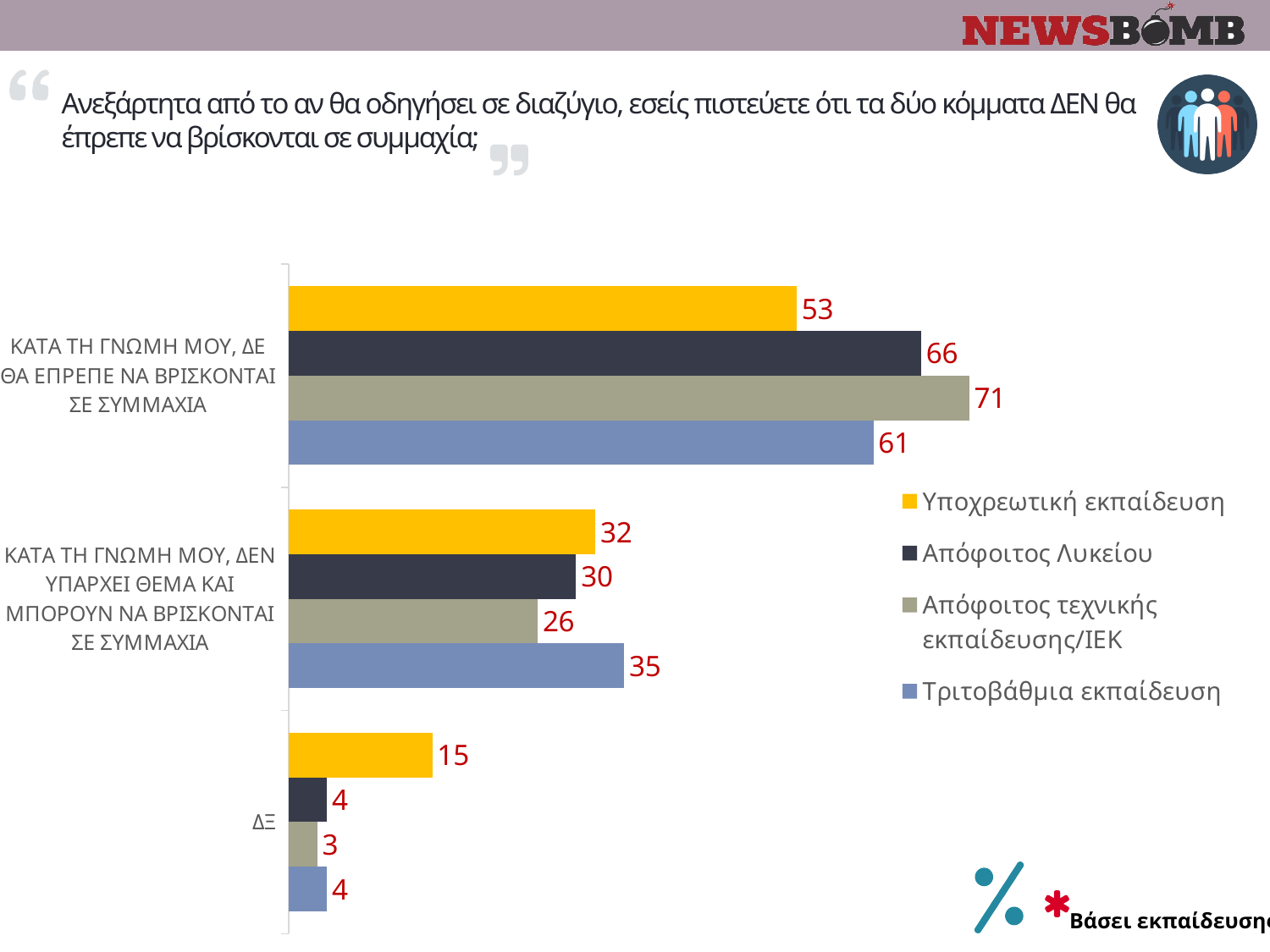
What is the value for Απόφοιτος τεχνικής εκπαίδευσης/ΙΕΚ in the category 'ΚΑΤΑ ΤΗ ΓΝΩΜΗ ΜΟΥ, ΔΕ ΘΑ ΕΠΡΕΠΕ ΝΑ ΒΡΙΣΚΟΝΤΑΙ ΣΕ ΣΥΜΜΑΧΙΑ'? 71 Which legend entry is shown in yellow? Υποχρεωτική εκπαίδευση What is the difference between the Υποχρεωτική εκπαίδευση value and the Απόφοιτος Λυκείου value in the category 'ΔΞ'? 11 Which education group has the lowest value in the category 'ΔΞ'? Απόφοιτος τεχνικής εκπαίδευσης/ΙΕΚ What kind of chart is shown on the slide? Bar chart What is the value for Υποχρεωτική εκπαίδευση in the category 'ΔΞ'? 15 Which education group has the highest value in the category 'ΚΑΤΑ ΤΗ ΓΝΩΜΗ ΜΟΥ, ΔΕ ΘΑ ΕΠΡΕΠΕ ΝΑ ΒΡΙΣΚΟΝΤΑΙ ΣΕ ΣΥΜΜΑΧΙΑ'? Απόφοιτος τεχνικής εκπαίδευσης/ΙΕΚ How many series does the legend list? 4 What is the value for Τριτοβάθμια εκπαίδευση in the category 'ΚΑΤΑ ΤΗ ΓΝΩΜΗ ΜΟΥ, ΔΕΝ ΥΠΑΡΧΕΙ ΘΕΜΑ ΚΑΙ ΜΠΟΡΟΥΝ ΝΑ ΒΡΙΣΚΟΝΤΑΙ ΣΕ ΣΥΜΜΑΧΙΑ'? 35 How many categories are shown on the vertical axis of the chart? 3 What is the difference between the Απόφοιτος τεχνικής εκπαίδευσης/ΙΕΚ value and the Υποχρεωτική εκπαίδευση value in the category 'ΚΑΤΑ ΤΗ ΓΝΩΜΗ ΜΟΥ, ΔΕ ΘΑ ΕΠΡΕΠΕ ΝΑ ΒΡΙΣΚΟΝΤΑΙ ΣΕ ΣΥΜΜΑΧΙΑ'? 18 In the category 'ΚΑΤΑ ΤΗ ΓΝΩΜΗ ΜΟΥ, ΔΕΝ ΥΠΑΡΧΕΙ ΘΕΜΑ ΚΑΙ ΜΠΟΡΟΥΝ ΝΑ ΒΡΙΣΚΟΝΤΑΙ ΣΕ ΣΥΜΜΑΧΙΑ', which is larger: the value for Υποχρεωτική εκπαίδευση or for Απόφοιτος τεχνικής εκπαίδευσης/ΙΕΚ? Υποχρεωτική εκπαίδευση